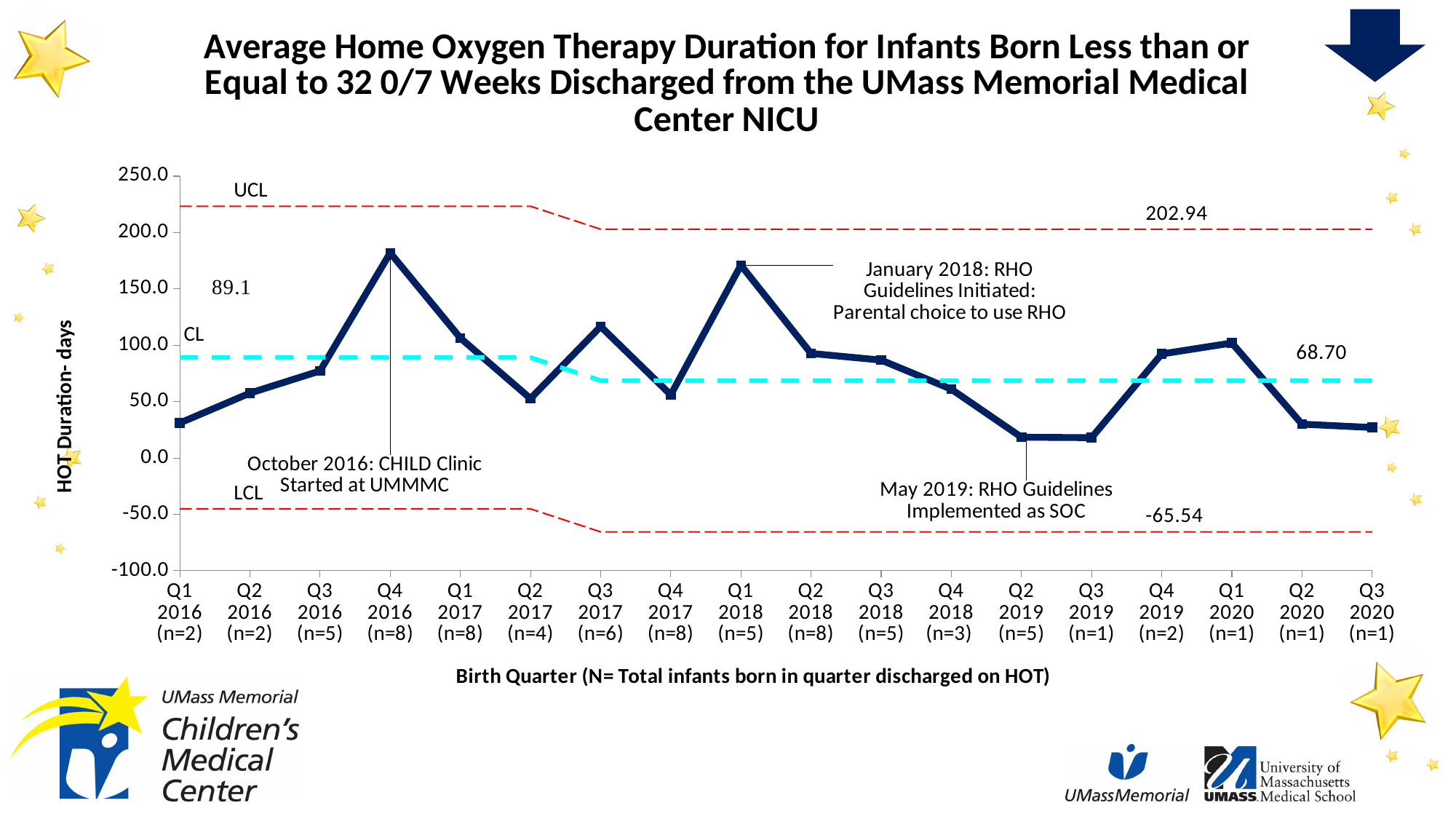
What is the value of the centre line (CL) in the earlier period of the chart? 89.1 What is the value of the lower control limit (LCL) in the later period of the chart? -65.54 Which birth quarter has the highest average HOT duration? Q4 2016 What kind of chart is shown on the slide? line chart What is the value of the upper control limit (UCL) in the later period of the chart? 202.94 What is the difference between the earlier centre line value (89.1) and the later centre line value (68.70)? 20.4 Which is larger, the value for Q3 2017 or the value for Q4 2017? Q3 2017 What is the value of the centre line (CL) in the later period of the chart? 68.70 How many birth quarters are plotted along the x axis? 18 Is the value for Q2 2019 greater or less than 50? less Is the value for Q4 2016 greater or less than 150? greater What is the label on the y axis? HOT Duration- days